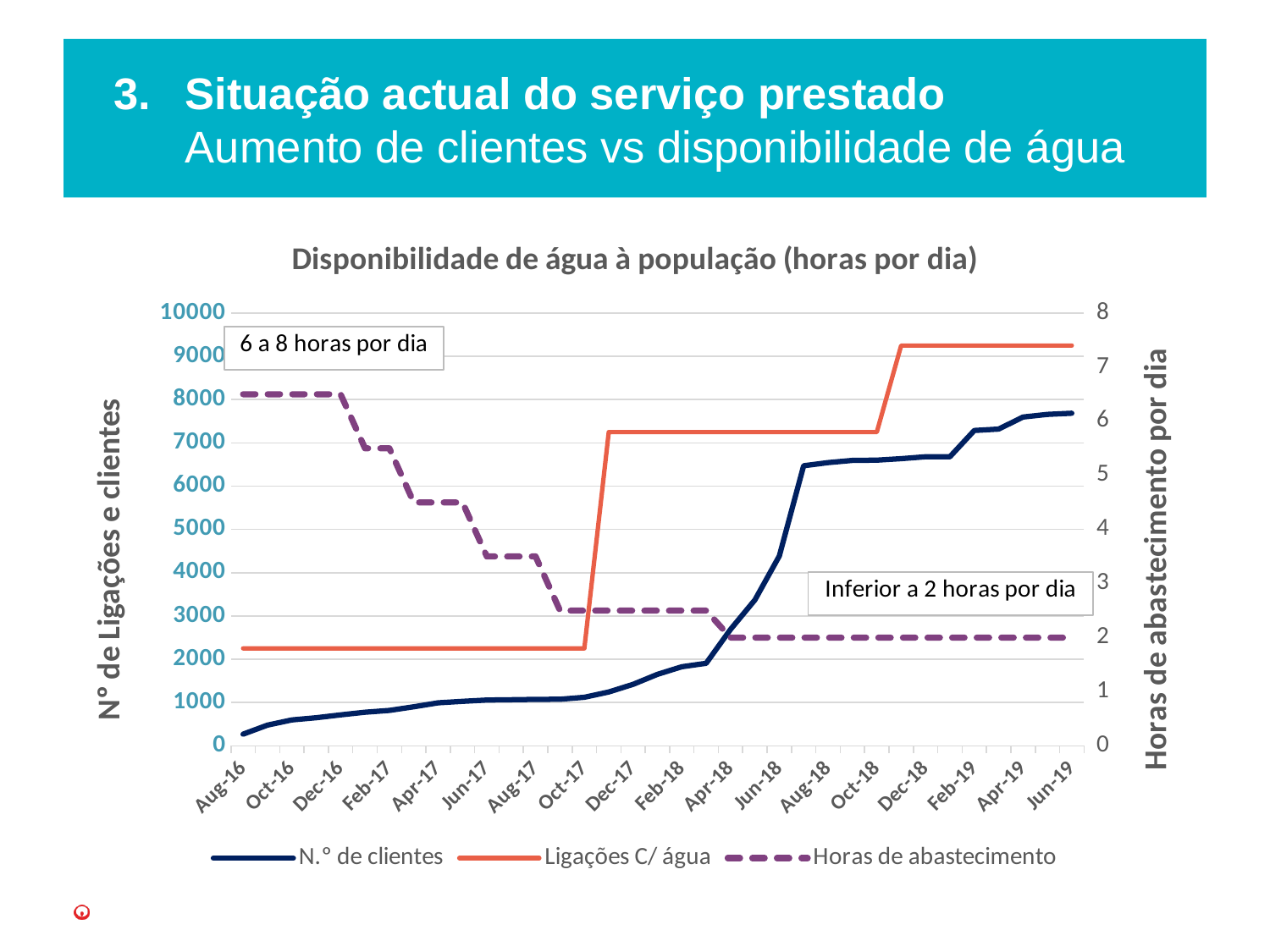
At Jun-19, which is higher: N.º de clientes or Ligações C/ água? Ligações C/ água Is the value for Ligações C/ água at Jun-19 greater or less than 8000? greater How many series does the legend list? 3 What is the title of the chart? Disponibilidade de água à população (horas por dia) What is the label of the right-hand vertical axis? Horas de abastecimento por dia Is the value for Horas de abastecimento at Aug-16 greater or less than 6 on the right axis? greater Does the Horas de abastecimento series rise or fall from Aug-16 to Jun-19? Fall Is the value for Ligações C/ água at Aug-16 greater or less than 3000? less Does the N.º de clientes series rise or fall from Aug-16 to Jun-19? Rise What kind of chart is shown on the slide? Line chart